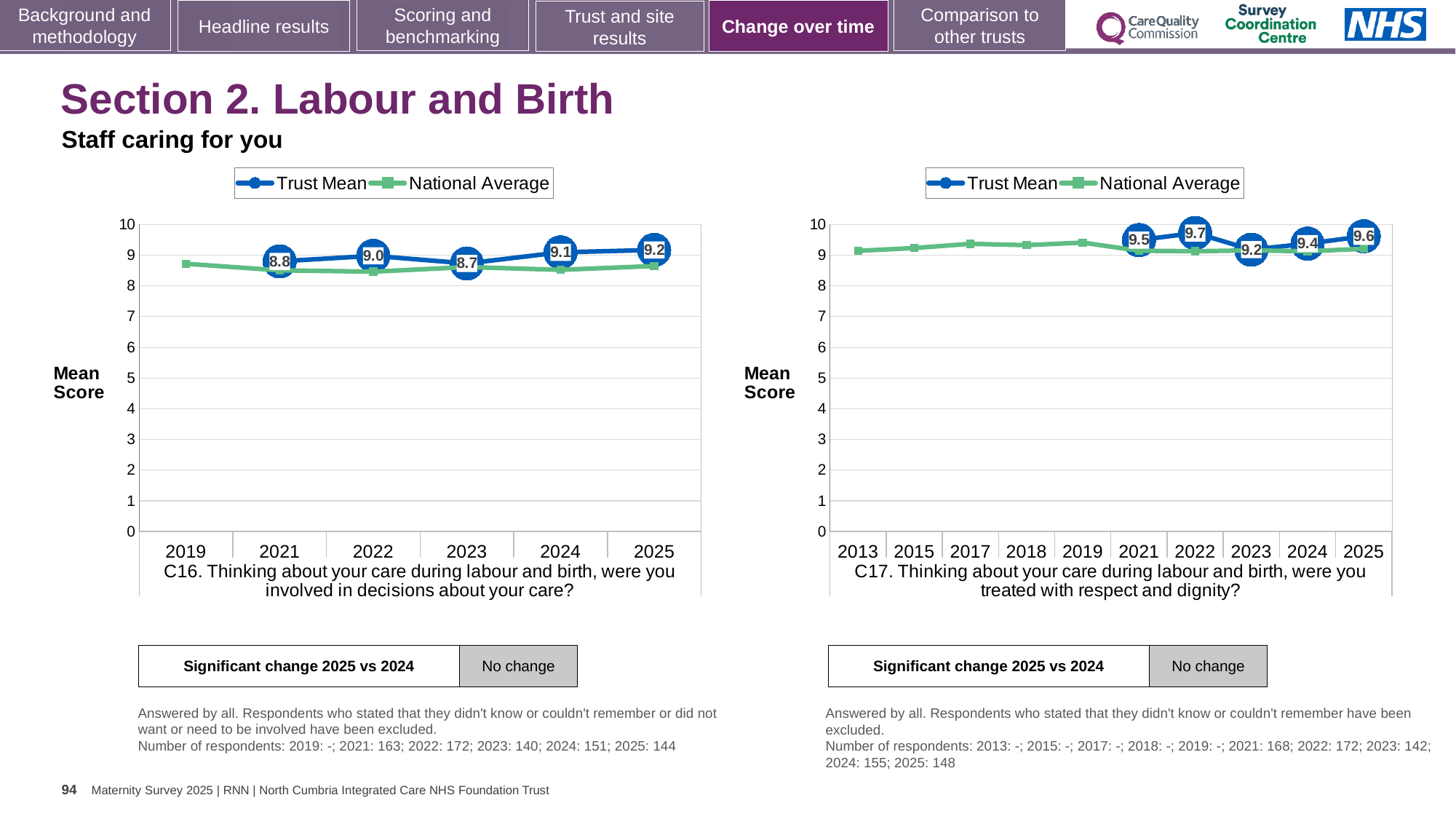
In the C16 chart (left), what is the Trust Mean for 2023? 8.7 In the C16 chart (left), what is the Trust Mean for 2025? 9.2 In the C17 chart (right), is the Trust Mean for 2022 or 2023 larger? 2022 What type of chart is the C16 chart (left)? Line chart In the C17 chart (right), which year has the highest Trust Mean? 2022 How many series does the legend of the C16 chart (left) list? 2 In the C16 chart (left), what is the difference between the Trust Mean for 2025 and 2023? 0.5 In the C17 chart (right), what is the Trust Mean for 2022? 9.7 In the C17 chart (right), what is the Trust Mean for 2023? 9.2 In the C16 chart (left), is the National Average for 2019 greater or less than 8? greater In the C16 chart (left), which year has the lowest Trust Mean? 2023 How many years are shown on the x axis of the C17 chart (right)? 10